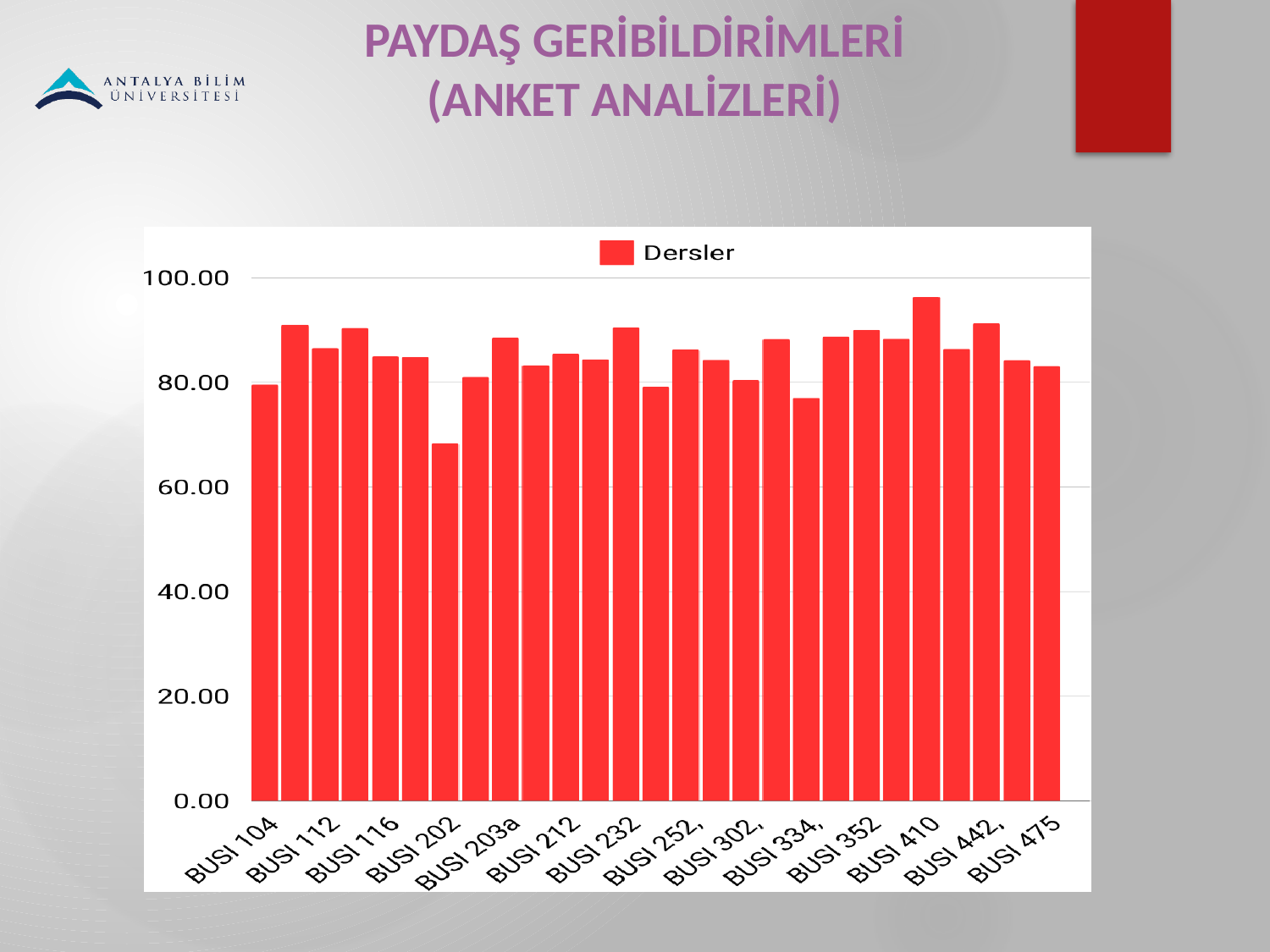
What is the name of the series shown in the legend? Dersler How many series does the legend list? 1 How many course labels are shown on the x axis? 14 Is the value for BUSI 334 greater or less than 80.00? less Is the value for BUSI 112 greater or less than 80.00? greater Which labeled course has the lowest bar? BUSI 202 What colour are the bars in the chart? red Is the value for BUSI 202 greater or less than 80.00? less Which labeled course has the highest bar? BUSI 410 Which is larger, the value for BUSI 410 or the value for BUSI 202? BUSI 410 What kind of chart is shown on the slide? bar chart